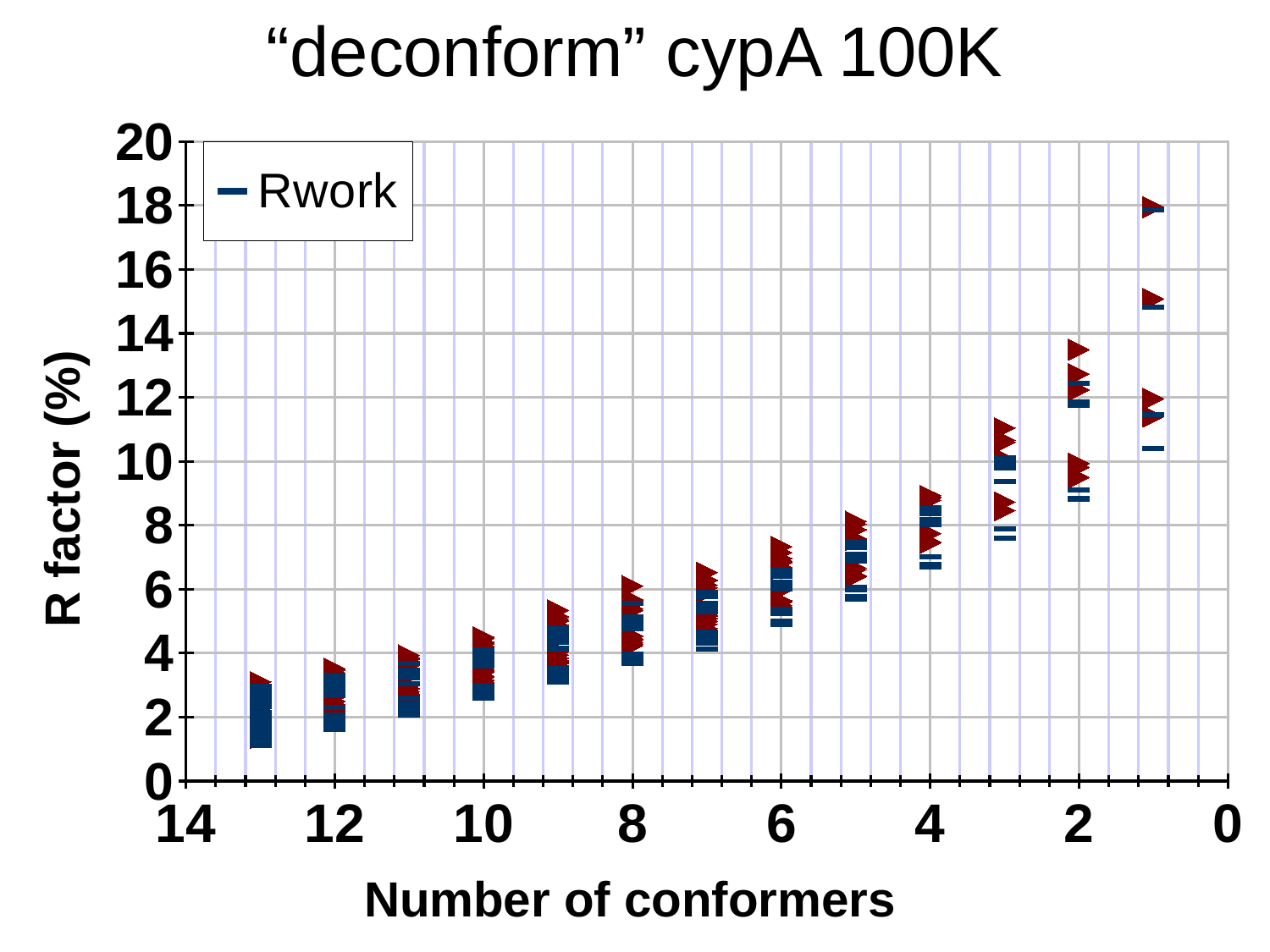
What is the title of the chart? “deconform” cypA 100K Which has larger Rwork values: 1 conformer or 13 conformers? 1 conformer Are the Rwork values at 13 conformers greater or less than 4? less What kind of chart is shown on the slide? scatter chart At which number of conformers are the highest R factor values plotted? 1 Moving from left to right along the x axis (from 14 conformers toward 0), do the R factor values rise or fall? rise What is the label of the y axis? R factor (%) At which number of conformers are the lowest R factor values plotted? 13 Are the Rwork values at 8 conformers greater or less than 2? greater How many series does the legend list? 1 Is the highest plotted value at 1 conformer greater or less than 16? greater